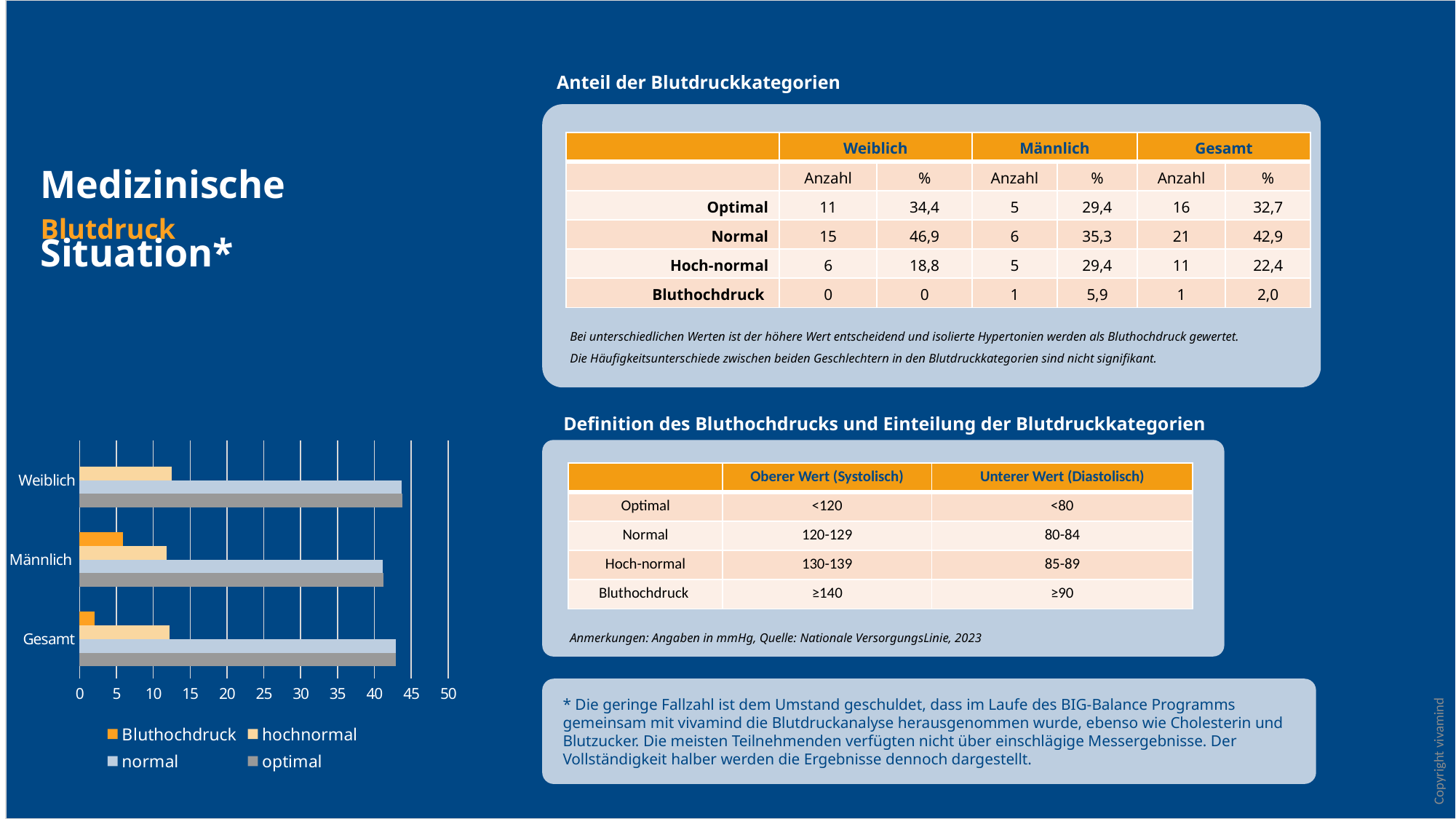
In the bar chart, is the value for hochnormal in the Männlich category greater or less than 10? greater In the bar chart, is the value for hochnormal in the Weiblich category greater or less than 15? less How many series does the legend of the bar chart list? 4 What colour is used for the Bluthochdruck series in the bar chart? orange In the bar chart, which category has the smallest Bluthochdruck value (no visible bar)? Weiblich What kind of chart is shown on the left of the slide? bar chart In the bar chart, is the value for normal in the Weiblich category greater or less than 40? greater In the bar chart, which is larger for Weiblich: the hochnormal bar or the normal bar? normal How many categories are shown on the bar chart? 3 In the bar chart, which is larger: the Bluthochdruck bar for Männlich or the Bluthochdruck bar for Gesamt? Männlich What is the highest tick value shown on the x axis of the bar chart? 50